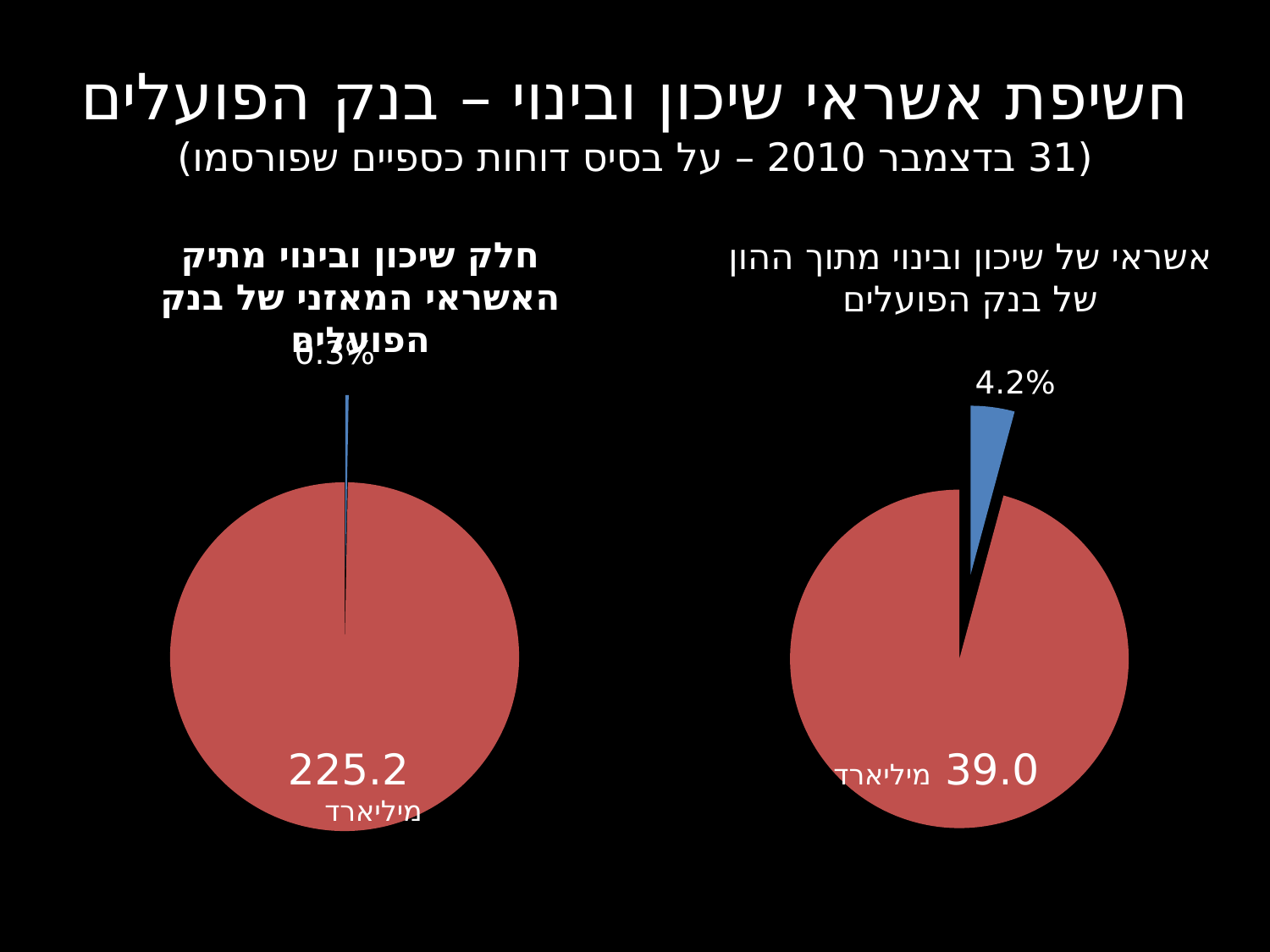
How many pie charts are on the slide? 2 Which slice is larger in the right pie chart, the blue slice or the red slice? the red slice Which pie chart has the larger blue slice, the left one or the right one? the right one What colour is the small slice in both pie charts? blue How many slices does the right pie chart have? 2 In the right pie chart, what value is printed on the large red slice? 39.0 מיליארד How many slices does the left pie chart have? 2 In the right pie chart, what percentage is printed on the small blue slice? 4.2% In the left pie chart, what percentage is printed on the small blue slice? 0.3% What kind of chart is shown on the right side of the slide? pie chart In the left pie chart, what value is printed on the large red slice? 225.2 מיליארד What kind of chart is shown on the left side of the slide? pie chart